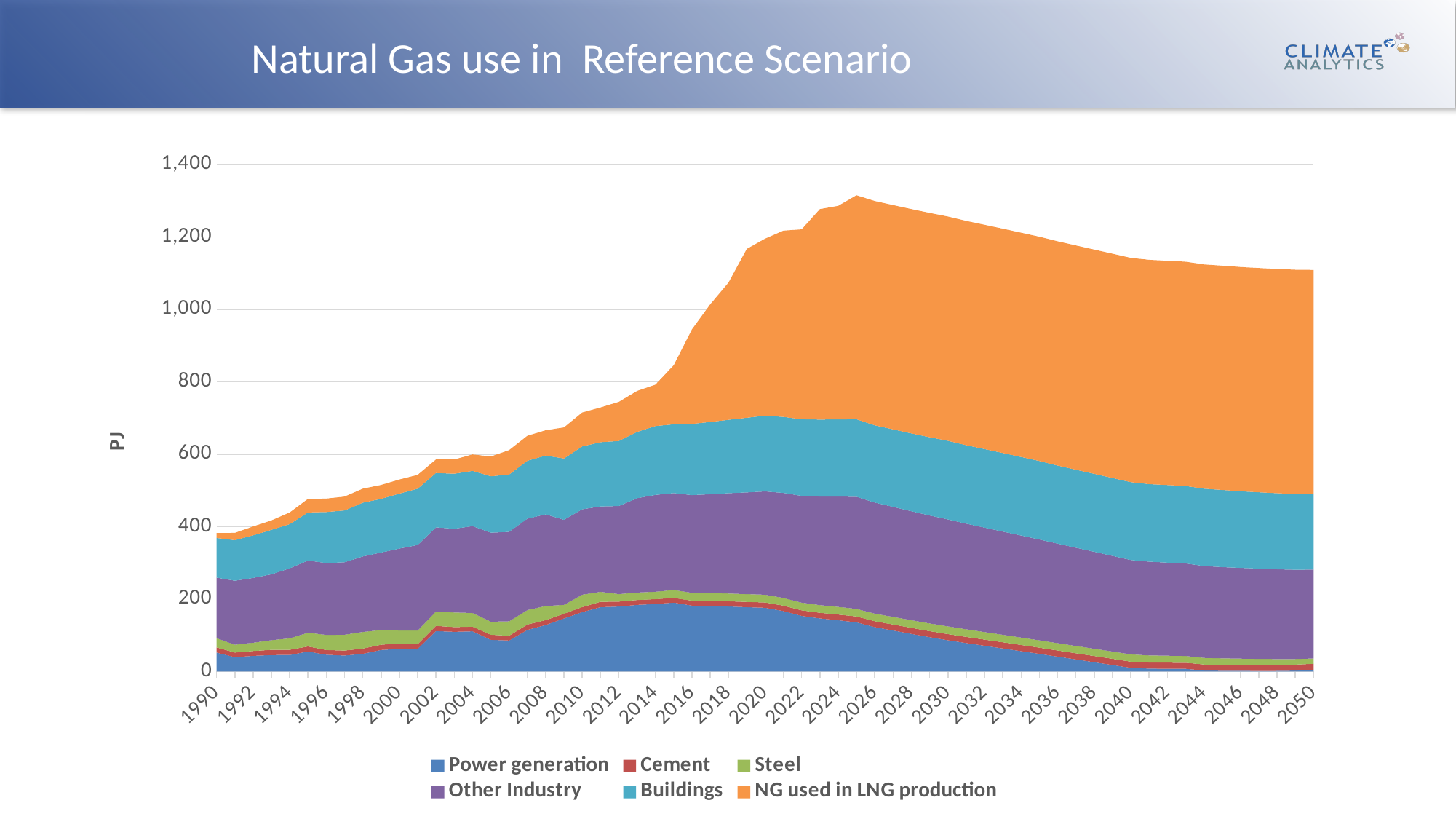
Does the total natural gas use rise or fall between 2030 and 2050? fall Is the peak total natural gas use greater or less than 1,200 PJ? greater Is the total natural gas use in 2050 greater or less than 1,000 PJ? greater How many series does the legend list? 6 Is the value for Power generation in 2020 greater or less than 100 PJ? greater Does the total natural gas use rise or fall between 1990 and 2020? rise What is the title of the chart? Natural Gas use in Reference Scenario What kind of chart is shown on the slide? Stacked area chart What unit is shown on the y axis? PJ